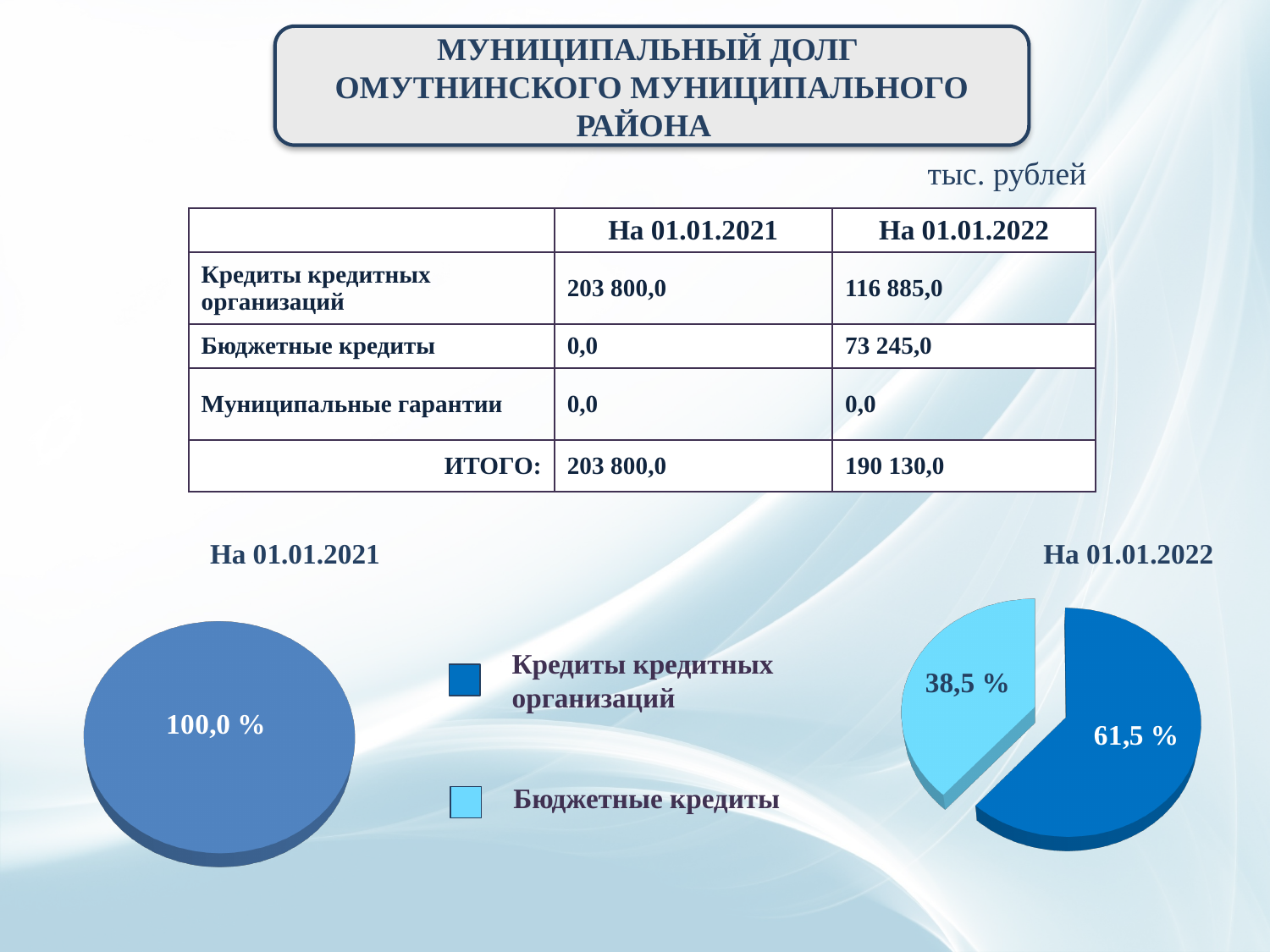
How many entries does the shared legend between the two pie charts list? 2 In the pie chart "На 01.01.2022", what is the difference in percentage points between the Кредиты кредитных организаций slice and the Бюджетные кредиты slice? 23,0 percentage points In the pie chart "На 01.01.2022", what share is labelled for Кредиты кредитных организаций? 61,5 % In the pie chart "На 01.01.2021", what share is labelled for Кредиты кредитных организаций? 100,0 % In the pie chart "На 01.01.2022", which category has the smallest slice? Бюджетные кредиты How many slices does the pie chart "На 01.01.2022" have? 2 In the pie chart "На 01.01.2022", which category has the largest slice? Кредиты кредитных организаций In the pie chart "На 01.01.2022", what share is labelled for Бюджетные кредиты? 38,5 % In the pie chart "На 01.01.2022", which slice is larger: Кредиты кредитных организаций or Бюджетные кредиты? Кредиты кредитных организаций What kind of chart is shown under the heading "На 01.01.2021"? pie chart In the legend between the two pie charts, which category is shown in light blue? Бюджетные кредиты How many slices does the pie chart "На 01.01.2021" have? 1